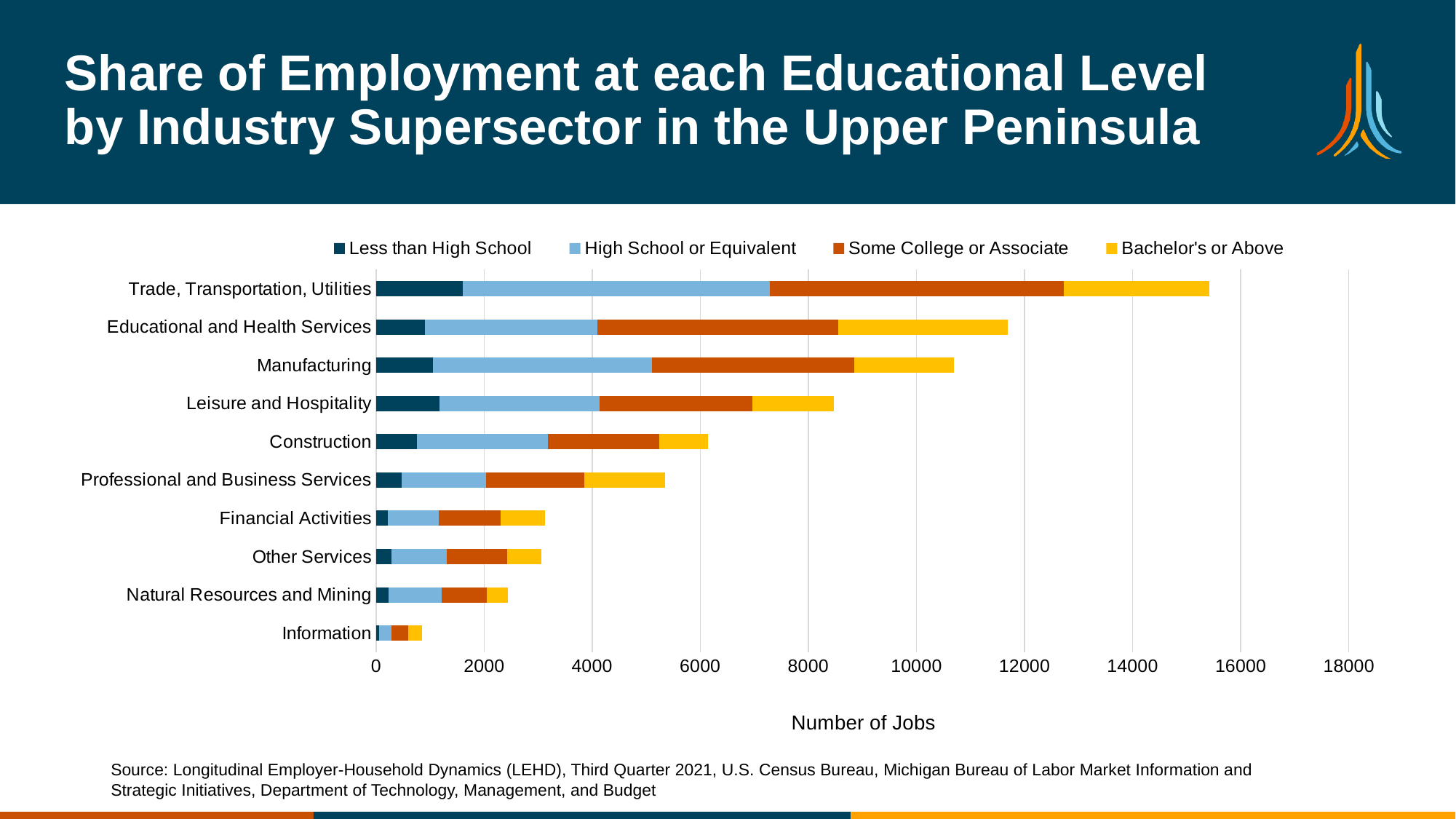
Which industry supersector has the largest total number of jobs? Trade, Transportation, Utilities Which industry supersector has the smallest total number of jobs? Information How many educational levels does the legend list? 4 Which educational level is shown in yellow in the legend? Bachelor's or Above Is the total number of jobs for Educational and Health Services greater or less than 12000? less Is the total number of jobs for Manufacturing greater or less than 10000? greater Which has a larger total number of jobs, Manufacturing or Leisure and Hospitality? Manufacturing What kind of chart is shown on the slide? Stacked bar chart How many industry supersectors are plotted on the chart? 10 What is the label on the horizontal axis of the chart? Number of Jobs Is the total number of jobs for Trade, Transportation, Utilities greater or less than 14000? greater